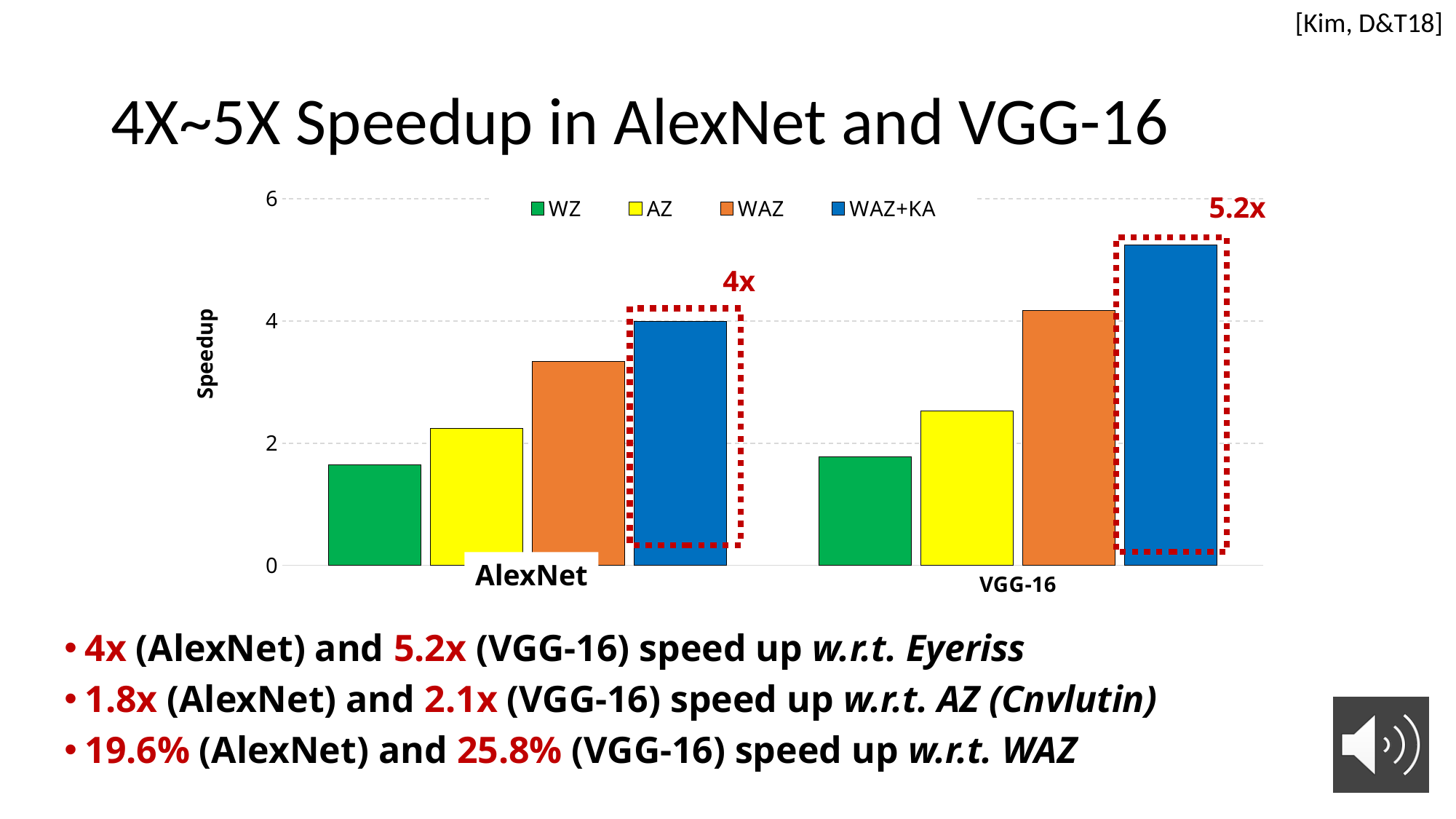
What is the difference between the labelled WAZ+KA speedups for VGG-16 and AlexNet? 1.2x Is the WAZ speedup for AlexNet greater or less than 4? less Is the WAZ speedup for VGG-16 greater or less than 4? greater Which network has the larger WAZ+KA speedup, AlexNet or VGG-16? VGG-16 How many series does the chart legend list? 4 What is the speedup value labelled for WAZ+KA on VGG-16? 5.2x What type of chart is shown on the slide? Bar chart Which series has the highest speedup for VGG-16? WAZ+KA Which series has the lowest speedup for AlexNet? WZ What is the speedup value labelled for WAZ+KA on AlexNet? 4x How many networks (categories) are shown on the x axis of the chart? 2 Is the WZ speedup for AlexNet greater or less than 2? less